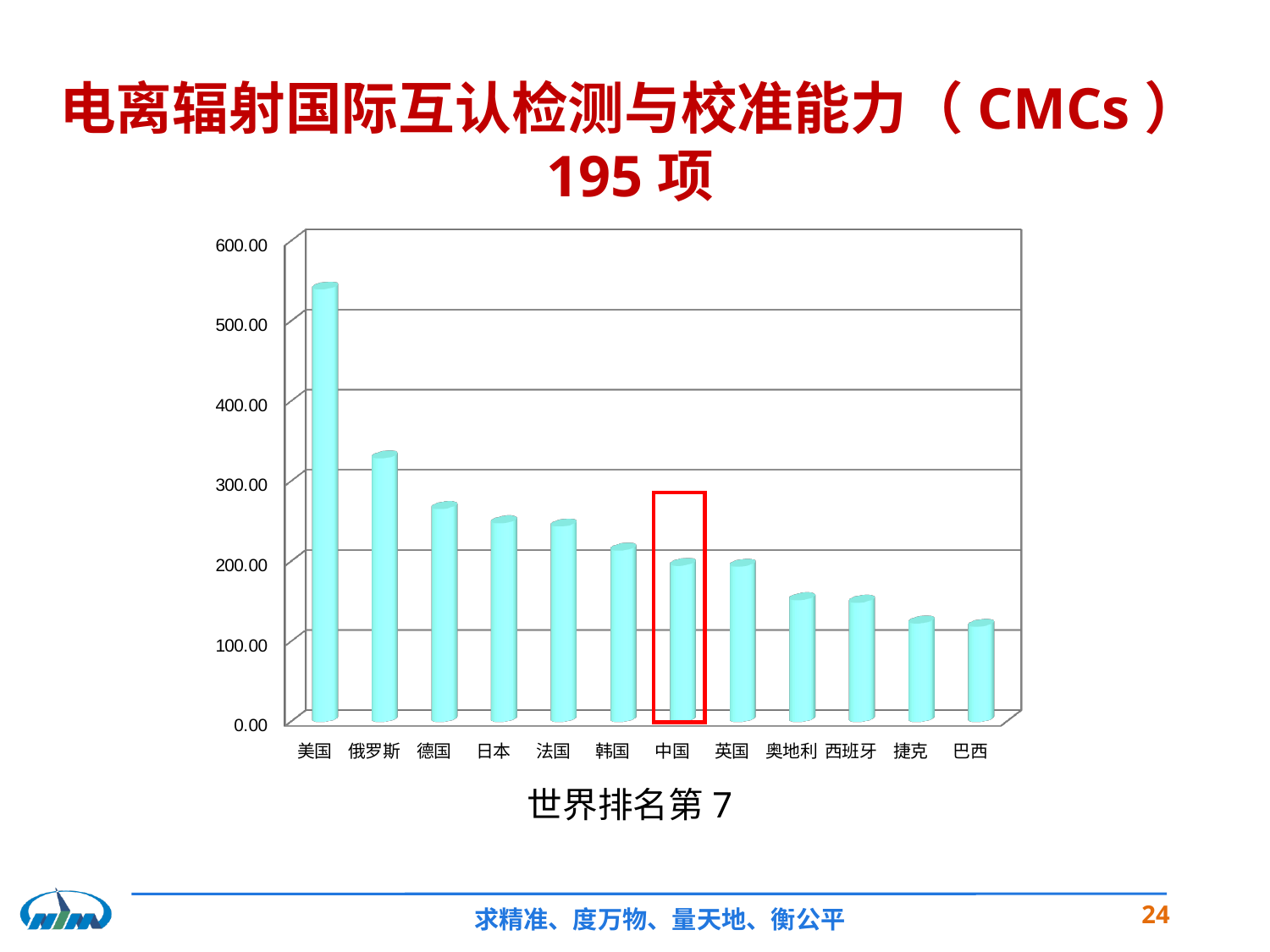
What kind of chart is shown on the slide? bar chart Which country's bar is outlined with a red box in the chart? 中国 Which has the larger value, 韩国 or 西班牙? 韩国 Is the value for 奥地利 greater or less than 200? less Is the value for 美国 greater or less than 500? greater Is the value for 俄罗斯 greater or less than 300? greater Do the bar values rise or fall from left to right along the x axis? fall Which has the larger value, 美国 or 俄罗斯? 美国 How many countries are shown on the x axis of the chart? 12 Which country has the highest bar in the chart? 美国